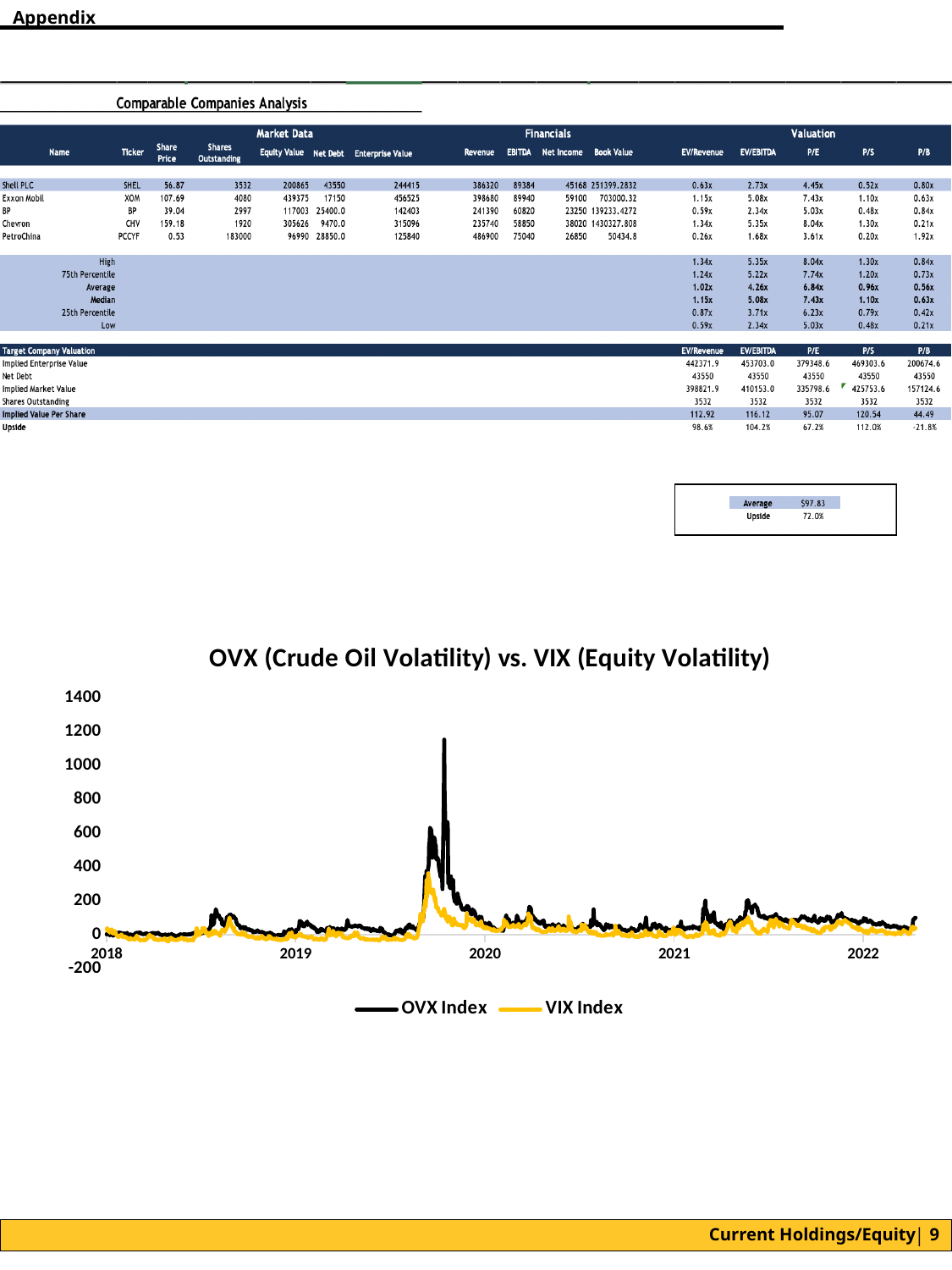
How many year labels are shown on the x axis of the OVX vs. VIX chart? 5 In the OVX vs. VIX chart, is the highest peak of the OVX Index greater or less than 1000? greater In the OVX vs. VIX chart, is the highest peak of the VIX Index greater or less than 600? less What kind of chart is shown under the title 'OVX (Crude Oil Volatility) vs. VIX (Equity Volatility)'? line chart What are the two series named in the legend of the OVX vs. VIX chart? OVX Index and VIX Index In the OVX vs. VIX chart, is the highest peak of the VIX Index greater or less than 200? greater In the OVX vs. VIX chart, which series reaches the higher peak, OVX Index or VIX Index? OVX Index What is the highest value labelled on the y axis of the OVX vs. VIX chart? 1400 In the OVX vs. VIX chart, which colour is used for the OVX Index line? black How many series does the legend of the OVX vs. VIX chart list? 2